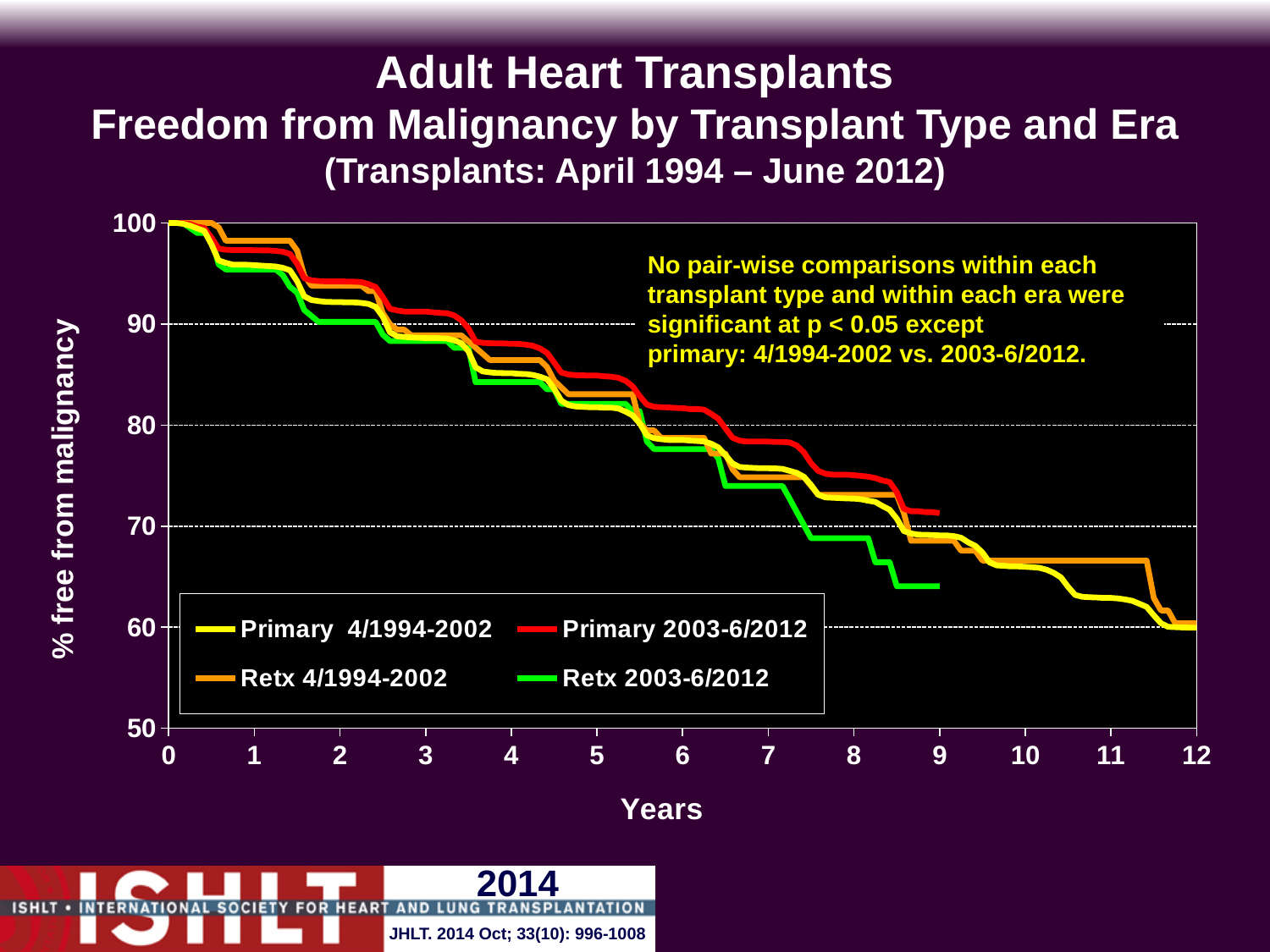
At year 8, which series has the higher value: Primary 2003-6/2012 or Retx 2003-6/2012? Primary 2003-6/2012 How many series does the legend list? 4 Which series has the lowest value at year 8? Retx 2003-6/2012 Is the value for Primary 4/1994-2002 at year 1 greater or less than 90? greater What is the label of the y axis? % free from malignancy What is the label of the x axis? Years Is the value for Retx 2003-6/2012 at year 9 greater or less than 70? less What kind of chart is shown on the slide? line chart Do the values for Primary 4/1994-2002 rise or fall as years increase? fall What is the value of all four series at year 0? 100 Is the value for Retx 2003-6/2012 at year 4 greater or less than 90? less